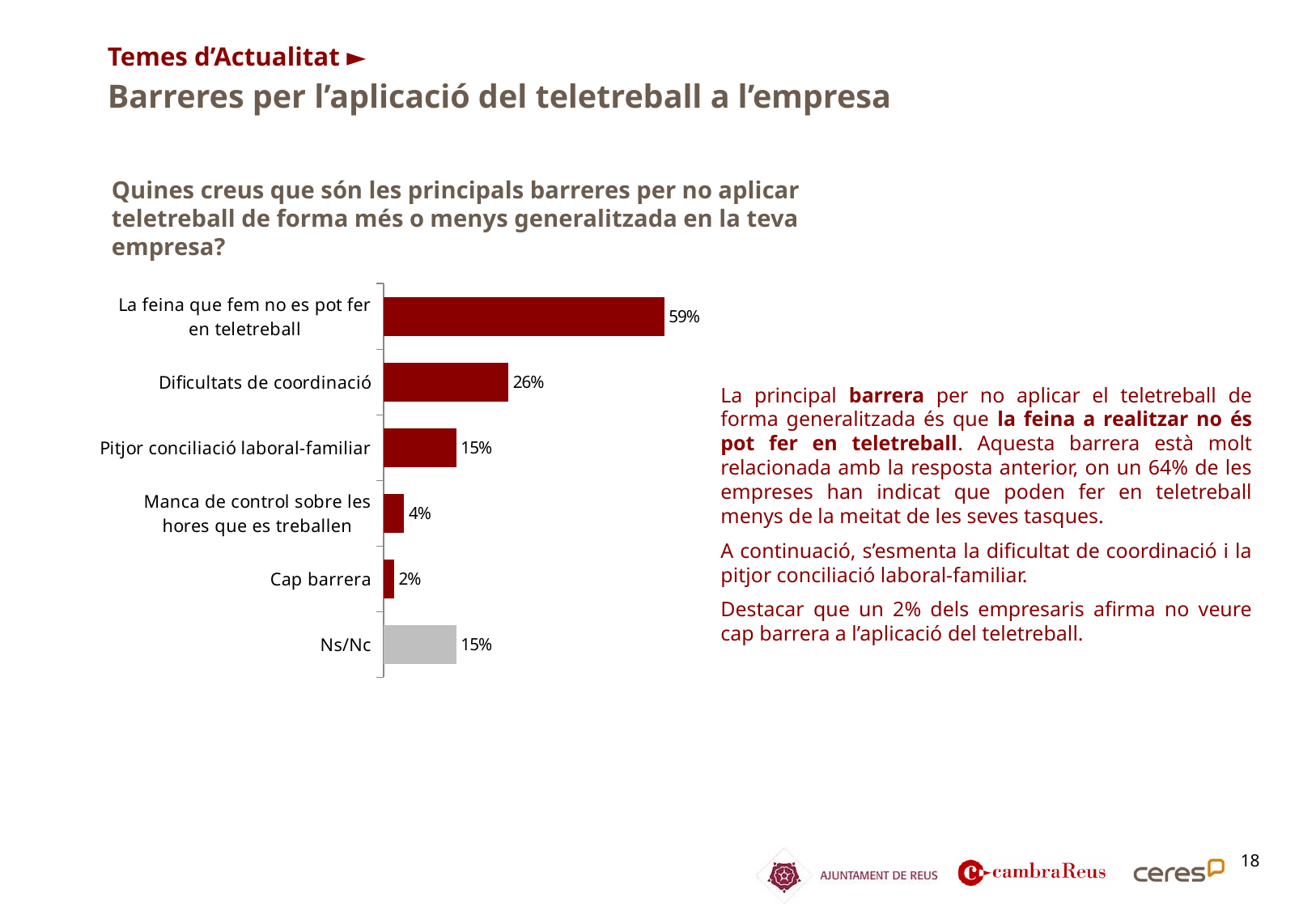
What is the difference between the values for "Pitjor conciliació laboral-familiar" and "Manca de control sobre les hores que es treballen"? 11% What is the value for "Cap barrera"? 2% Which is larger, the value for "Dificultats de coordinació" or the value for "Pitjor conciliació laboral-familiar"? Dificultats de coordinació Which bar in the chart is coloured grey rather than dark red? Ns/Nc What is the value for "Manca de control sobre les hores que es treballen"? 4% What is the value for "La feina que fem no es pot fer en teletreball"? 59% How many categories are shown in the chart? 6 Which category has the highest value? La feina que fem no es pot fer en teletreball Which category has the lowest value? Cap barrera What kind of chart is shown on the slide? Bar chart What is the difference between the values for "La feina que fem no es pot fer en teletreball" and "Dificultats de coordinació"? 33% What is the value for "Dificultats de coordinació"? 26%